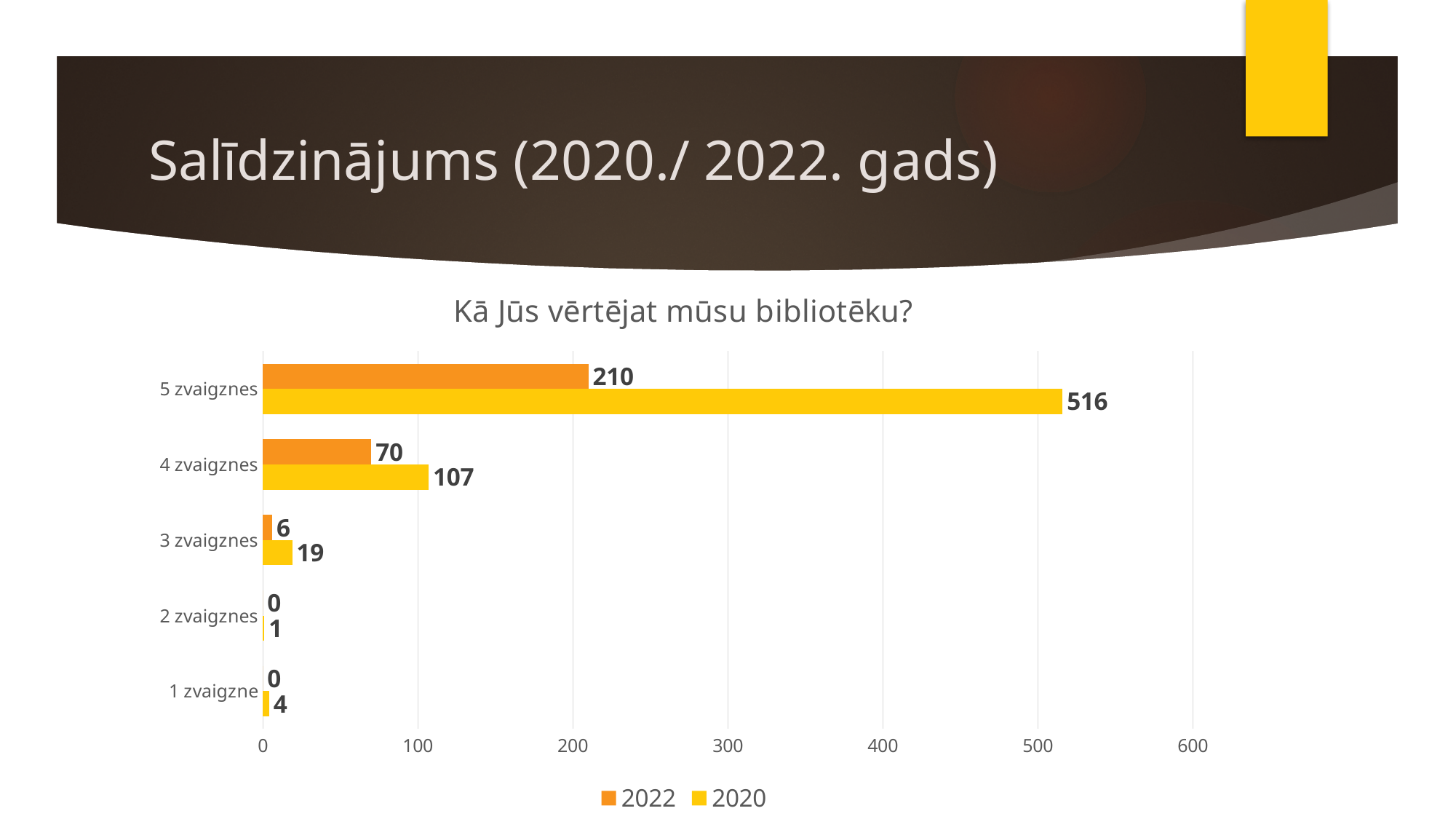
What is the difference between the 2020 and 2022 values for 5 zvaigznes? 306 What is the title of the chart? Kā Jūs vērtējat mūsu bibliotēku? How many categories are shown on the chart? 5 Which is larger for 4 zvaigznes: the 2020 value or the 2022 value? 2020 How many series does the legend list? 2 Which category has the highest value in the 2022 series? 5 zvaigznes What is the value for 3 zvaigznes in the 2020 series? 19 Which category has the lowest value in the 2020 series? 2 zvaigznes What is the value for 1 zvaigzne in the 2020 series? 4 What is the value for 4 zvaigznes in the 2022 series? 70 What kind of chart is shown on the slide? Bar chart What is the value for 5 zvaigznes in the 2020 series? 516